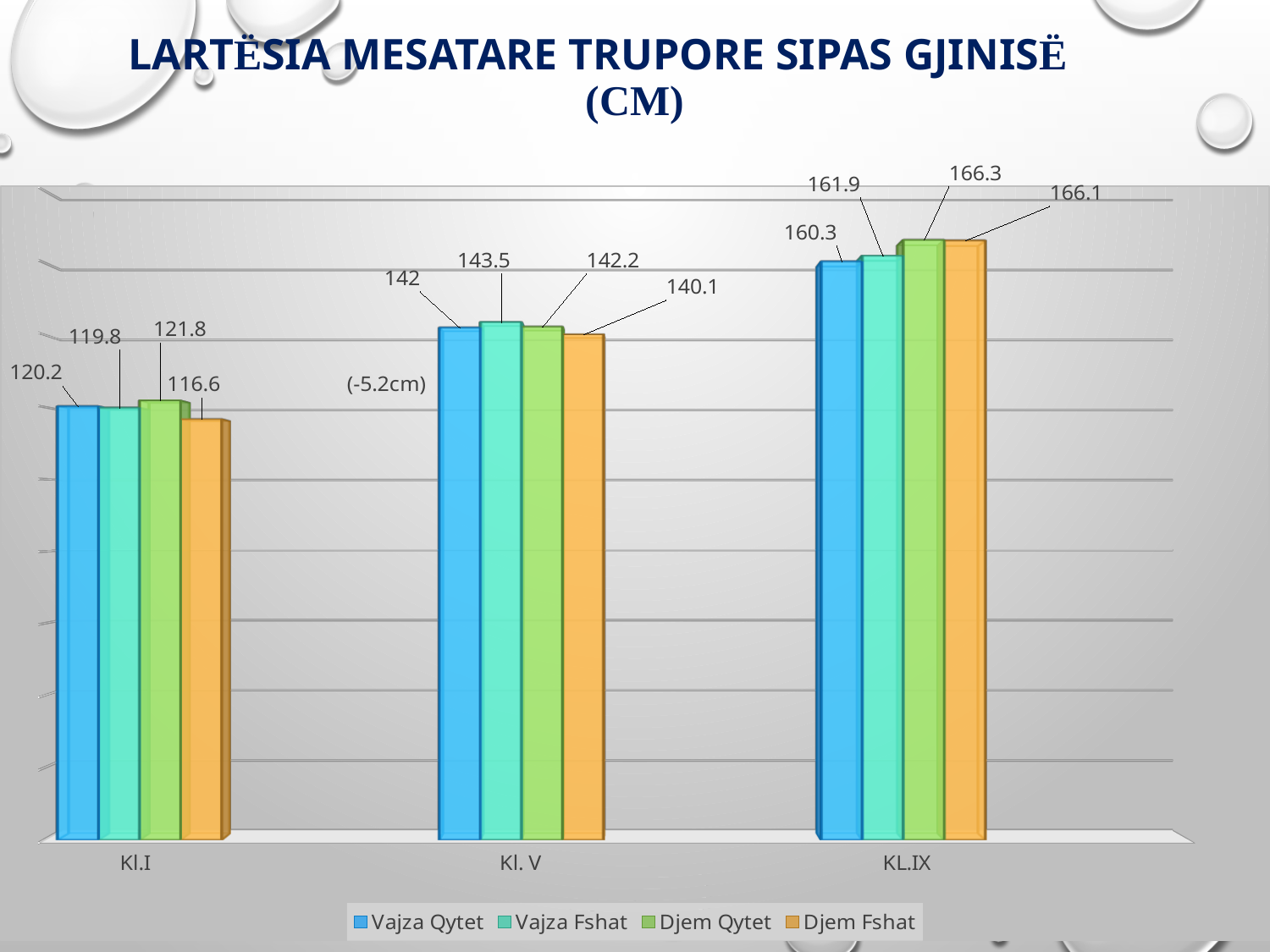
What is the value for Djem Fshat in Kl. V? 140.1 How many series does the legend list? 4 What kind of chart is shown on the slide? Bar chart What is the value for Djem Qytet in KL.IX? 166.3 Which series has the highest value in Kl. V? Vajza Fshat What is the value for Vajza Qytet in Kl.I? 120.2 How many categories are shown on the x axis? 3 What is the difference between Djem Qytet and Vajza Qytet in KL.IX? 6 What is the difference between Djem Qytet and Djem Fshat in Kl.I? 5.2 Which series has the lowest value in Kl.I? Djem Fshat What is the value for Vajza Fshat in KL.IX? 161.9 Which is larger in Kl. V: Vajza Qytet or Djem Fshat? Vajza Qytet